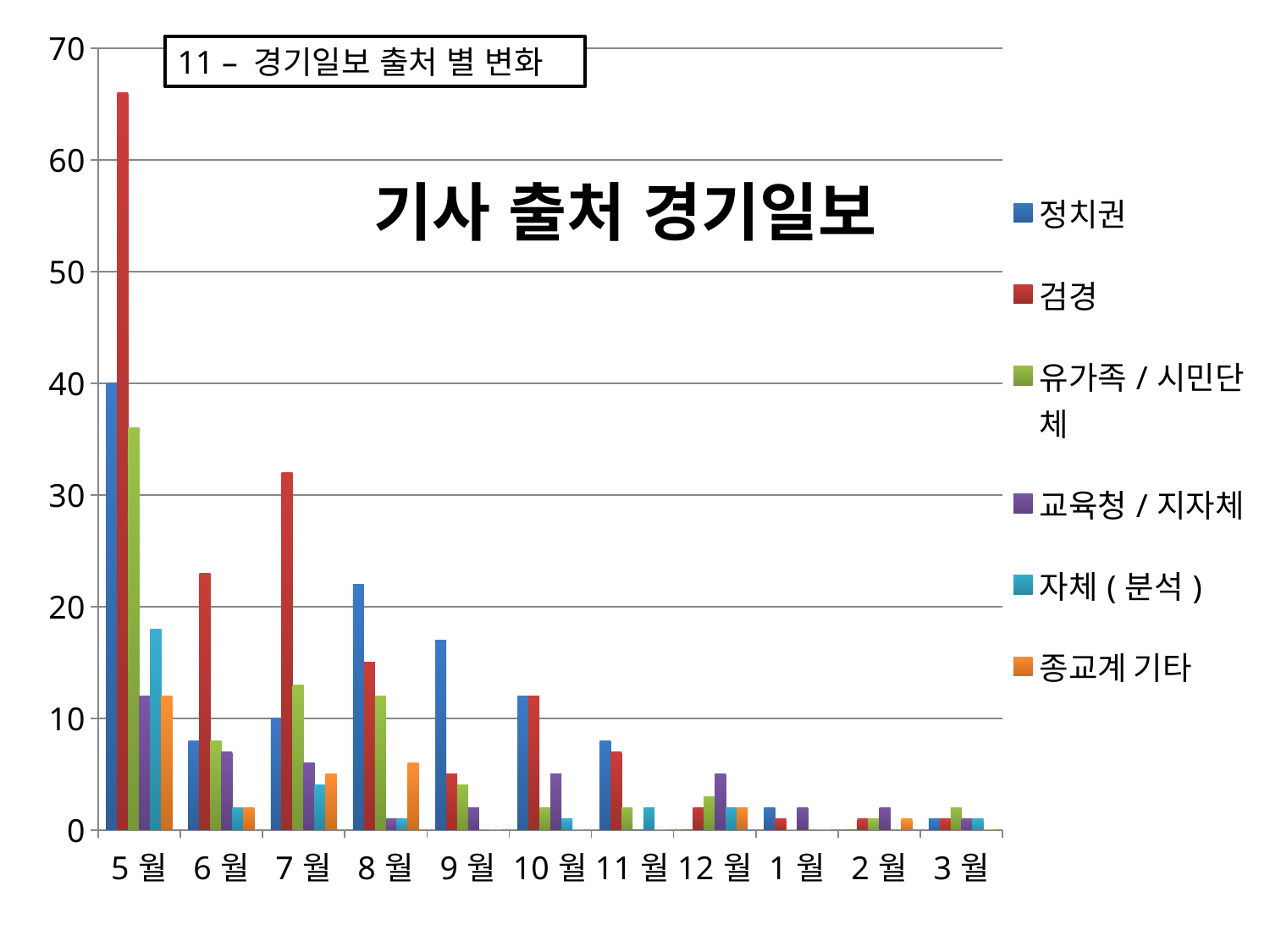
What kind of chart is shown on the slide? bar chart How many series does the legend list? 6 Which series has the tallest bar in 5 월? 검경 Is the value for 정치권 in 8 월 greater or less than 20? greater Does the value for 검경 generally rise or fall from 5 월 to 3 월? fall What is the title of the chart? 기사 출처 경기일보 How many months are shown along the x axis? 11 Is the value for 검경 in 7 월 greater or less than 30? greater Which is larger in 9 월, 정치권 or 검경? 정치권 Is the value for 유가족 / 시민단체 in 6 월 greater or less than 10? less Which month has the highest value for 검경? 5 월